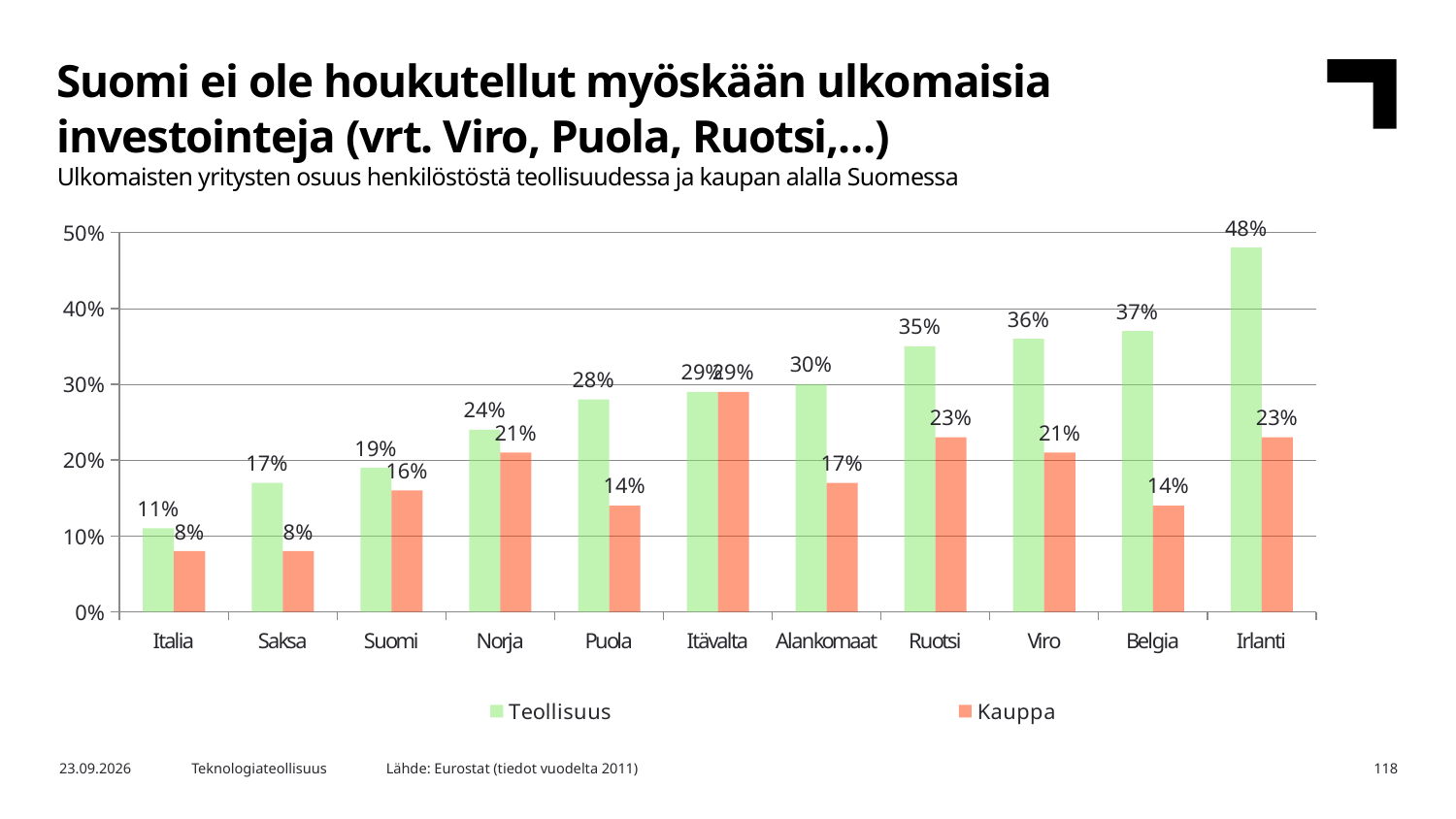
How many series does the legend list? 2 What is the Teollisuus value for Suomi? 19% What is the Kauppa value for Ruotsi? 23% What kind of chart is shown on the slide? Bar chart Do the Teollisuus values rise or fall from Italia to Irlanti along the x axis? Rise What is the difference between the Teollisuus values for Irlanti and Suomi? 29% Which series is shown in green in the legend? Teollisuus Which is larger, the Kauppa value for Norja or the Kauppa value for Puola? Norja Which country has the lowest Teollisuus value? Italia Which country has the highest Teollisuus value? Irlanti How many countries are shown on the x axis? 11 What is the Kauppa value for Itävalta? 29%